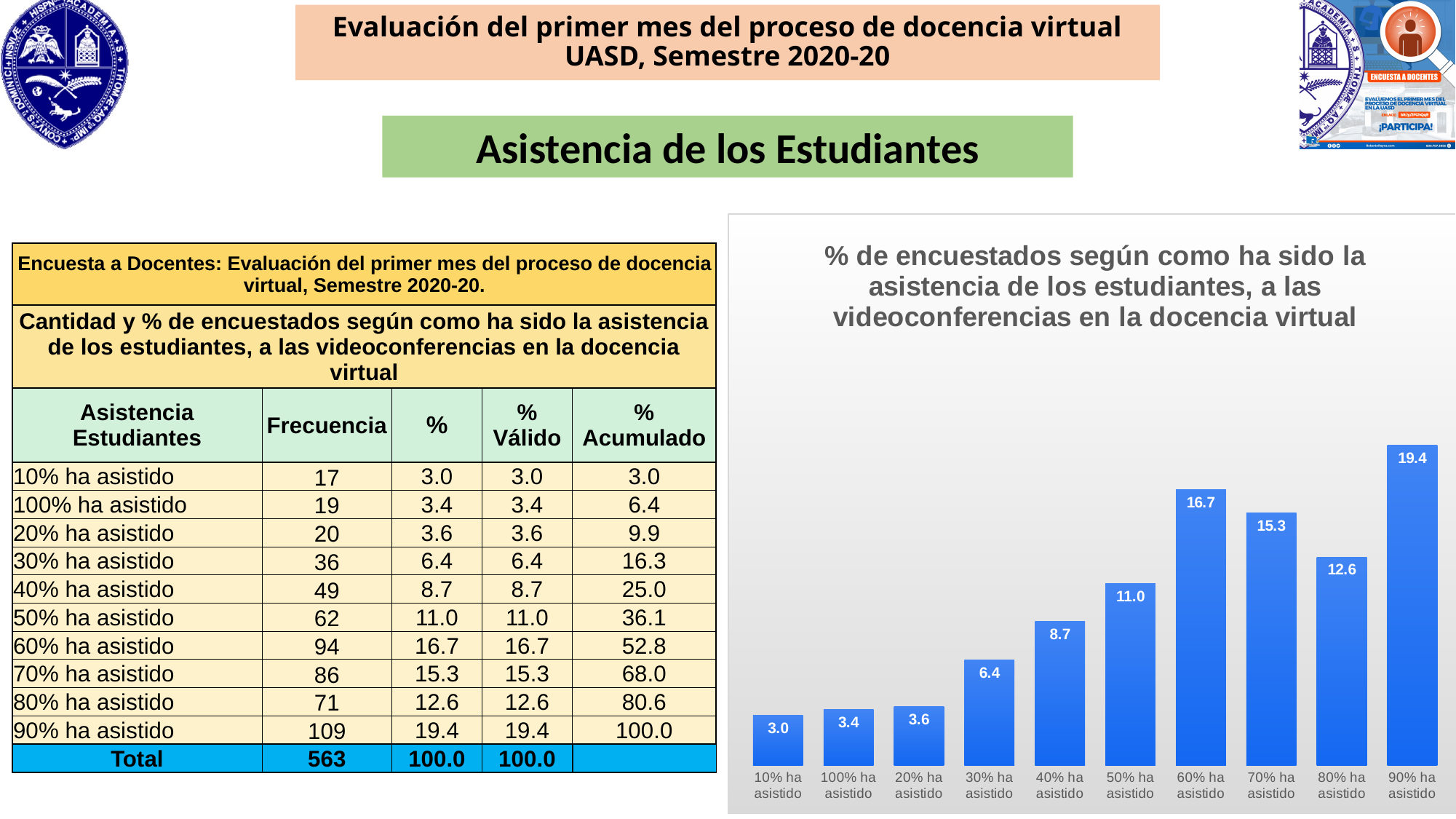
What colour are the bars in the chart? Blue What is the difference between the values for "30% ha asistido" and "20% ha asistido"? 2.8 Which category has the lowest value in the chart? 10% ha asistido Which is larger: the value for "70% ha asistido" or the value for "50% ha asistido"? 70% ha asistido What is the difference between the values for "90% ha asistido" and "80% ha asistido"? 6.8 What is the value for "10% ha asistido" in the chart? 3.0 Which category has the highest value in the chart? 90% ha asistido What kind of chart is shown on the slide? Bar chart What is the value for "60% ha asistido" in the chart? 16.7 What is the value for "40% ha asistido" in the chart? 8.7 How many categories are shown in the chart? 10 What is the title of the chart? % de encuestados según como ha sido la asistencia de los estudiantes, a las videoconferencias en la docencia virtual